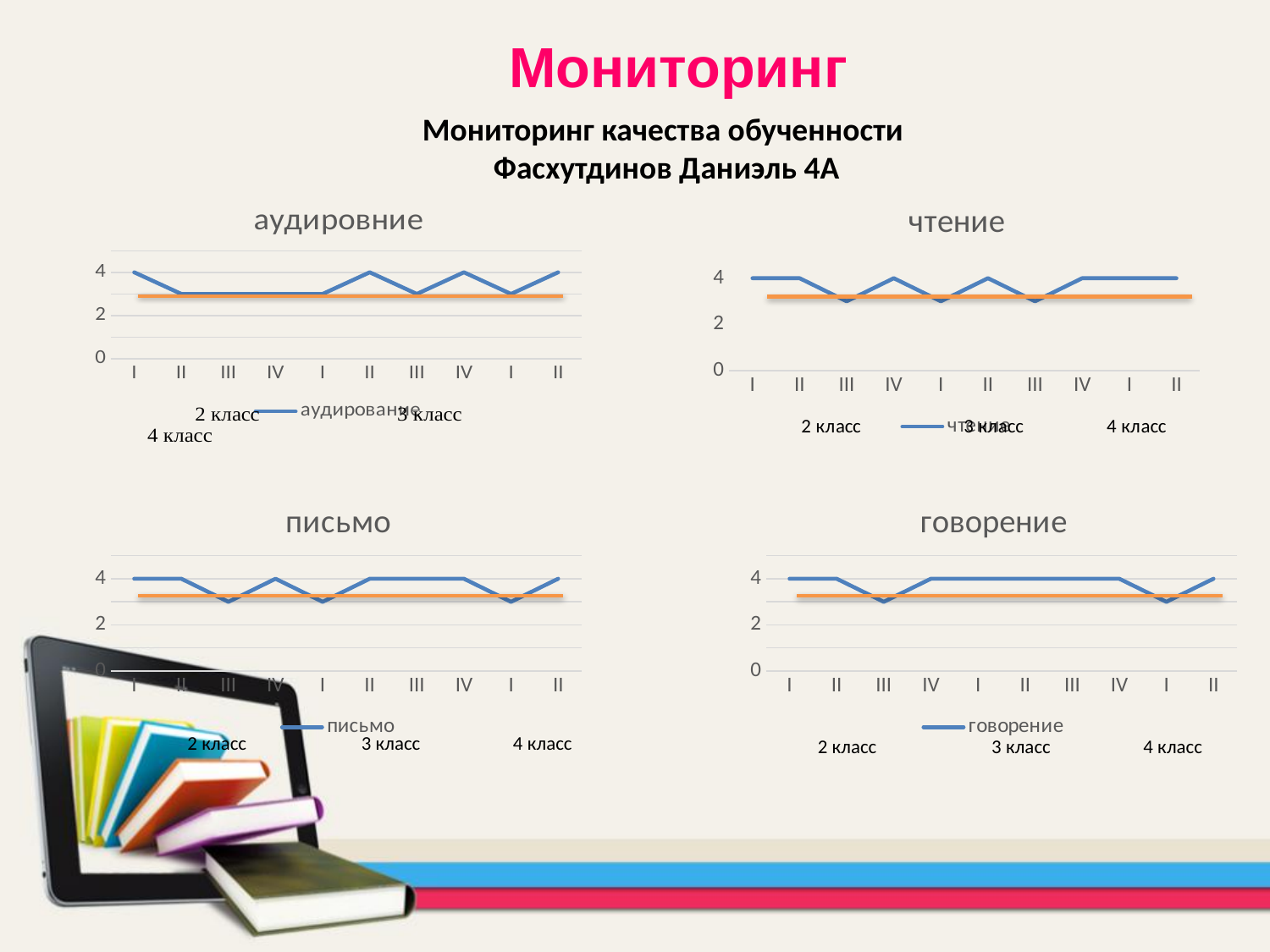
In the 'чтение' chart, what is the value at the first point labelled I? 4 What is the legend entry of the 'говорение' chart? говорение In the 'письмо' chart, is the value at the first point labelled III greater or less than 2? greater In the 'письмо' chart, what is the value at the first point labelled I? 4 In the 'говорение' chart, what is the value at the last point labelled II? 4 In the 'аудировние' chart, how many points are plotted along the x axis? 10 How many series does the legend of the 'чтение' chart list? 1 What kind of chart is the 'аудировние' chart? line chart In the 'чтение' chart, which is larger: the value at the first point labelled II or the value at the first point labelled III? the first point labelled II In the 'говорение' chart, which is larger: the value at the first point labelled III or the value at the first point labelled IV? the first point labelled IV In the 'аудировние' chart, is the value at the first point labelled IV greater or less than 4? less What is the title of the chart in the bottom-left of the slide? письмо